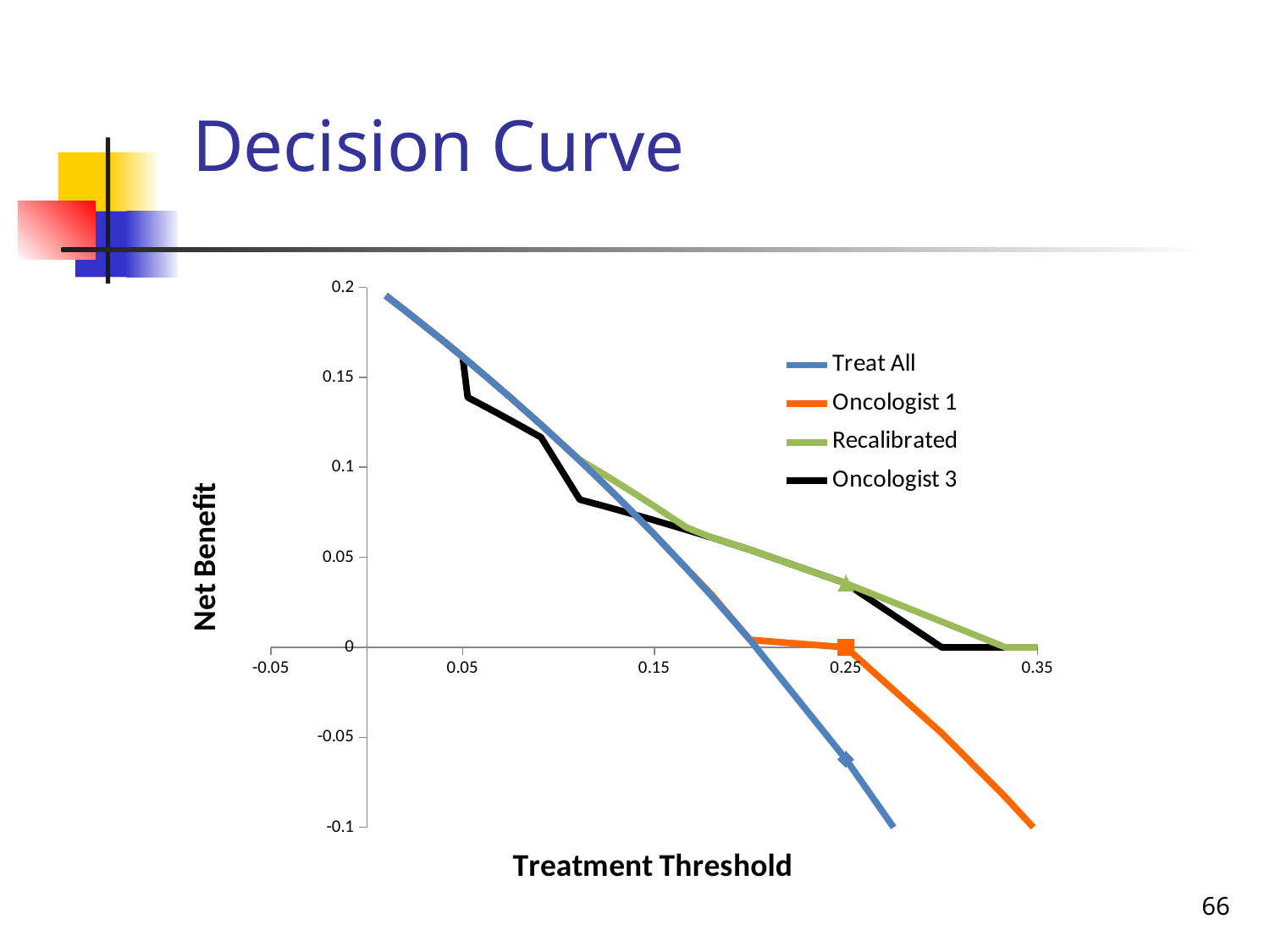
What is the label of the vertical axis? Net Benefit How many series does the legend list? 4 At a Treatment Threshold of 0.35, which has the higher Net Benefit, Recalibrated or Oncologist 1? Recalibrated Is the Net Benefit for Recalibrated at a Treatment Threshold of 0.25 greater or less than 0.05? less Is the Net Benefit for Recalibrated at a Treatment Threshold of 0.25 greater or less than 0? greater Does the Treat All line rise or fall as Treatment Threshold increases? fall Does the Recalibrated line rise or fall as Treatment Threshold increases? fall Is the Net Benefit for Treat All at a Treatment Threshold of 0.15 greater or less than 0.1? less What kind of chart is shown on the slide? line chart At a Treatment Threshold of 0.25, which has the higher Net Benefit, Recalibrated or Treat All? Recalibrated What is the title of the chart? Decision Curve